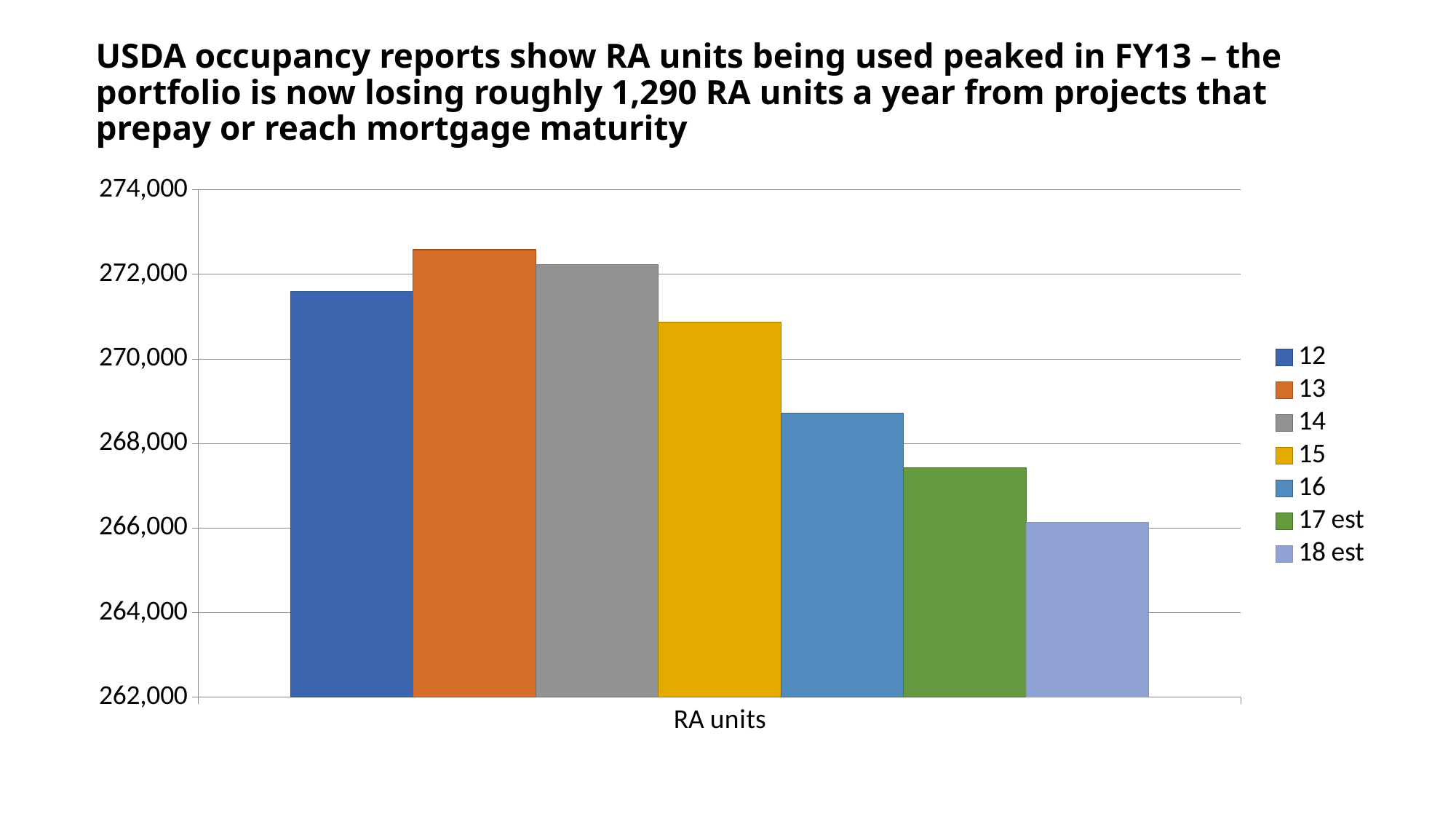
Which is larger, the value for 14 or the value for 15? 14 What kind of chart is shown on the slide? bar chart Is the value for 12 greater or less than 270,000? greater Which series has the highest value? 13 Which is larger, the value for 12 or the value for 13? 13 What is the label shown on the x axis of the chart? RA units How many bars are plotted in the chart? 7 Is the value for 16 greater or less than 270,000? less Is the value for 17 est greater or less than 268,000? less Which series has the lowest value? 18 est Do the values rise or fall from series 13 through 18 est? fall How many series does the legend list? 7